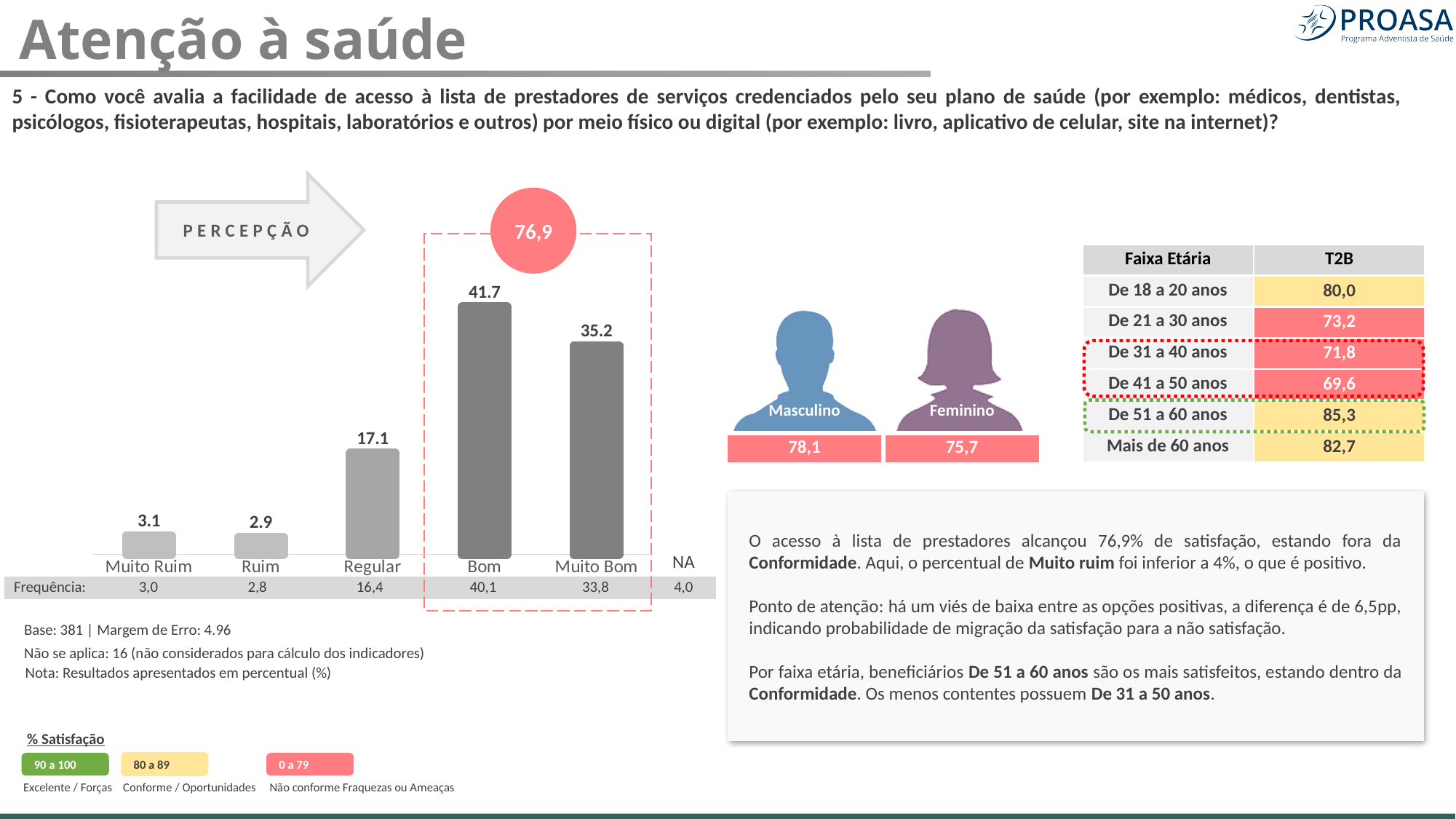
What value is shown in the pink circle above the highlighted Bom and Muito Bom bars? 76,9 What is the difference between the values for Regular and Ruim? 14.2 What is the value for Regular in the bar chart? 17.1 Which category has the highest value in the bar chart? Bom What is the value for Bom in the bar chart? 41.7 How many bars are plotted in the bar chart? 5 What is the difference between the values for Bom and Muito Bom? 6.5 Which category has the lowest value in the bar chart? Ruim Which is larger, the value for Bom or the value for Muito Bom? Bom What kind of chart is shown on the slide? bar chart What is the value for Muito Ruim in the bar chart? 3.1 What is the value for Muito Bom in the bar chart? 35.2